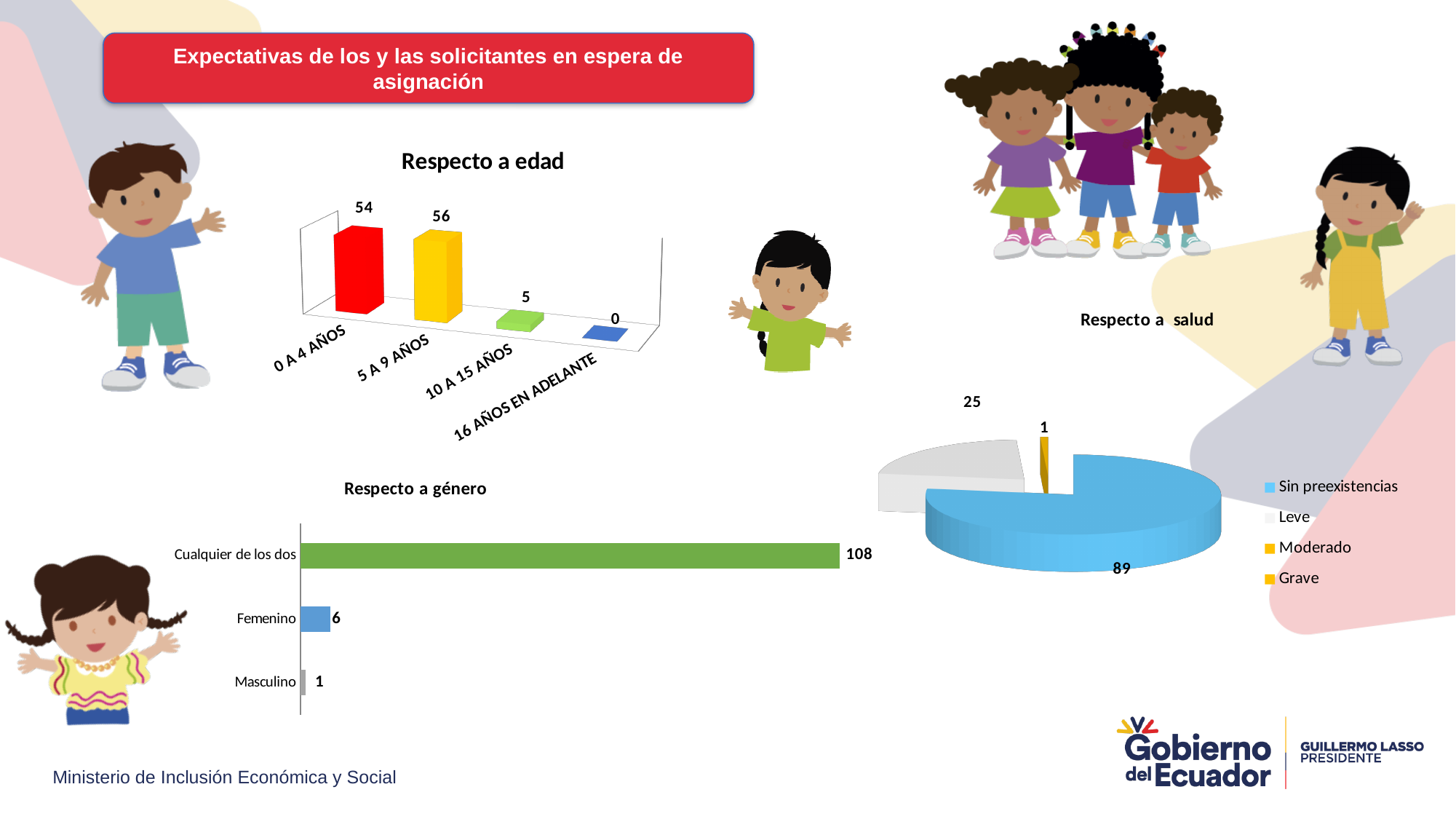
How many entries does the legend of the 'Respecto a salud' chart list? 4 In the 'Respecto a salud' chart, what is the value for Leve? 25 In the 'Respecto a edad' chart, what is the value for 5 A 9 AÑOS? 56 In the 'Respecto a edad' chart, how many age categories are shown? 4 In the 'Respecto a género' chart, which category has the lowest value? Masculino In the 'Respecto a género' chart, which is larger, Femenino or Masculino? Femenino What kind of chart is 'Respecto a género'? Bar chart In the 'Respecto a salud' chart, which category has the largest slice? Sin preexistencias In the 'Respecto a edad' chart, what is the difference between the values for 0 A 4 AÑOS and 10 A 15 AÑOS? 49 In the 'Respecto a edad' chart, which age group has the lowest value? 16 AÑOS EN ADELANTE In the 'Respecto a género' chart, what is the value for Cualquier de los dos? 108 In the 'Respecto a edad' chart, which age group has the highest value? 5 A 9 AÑOS